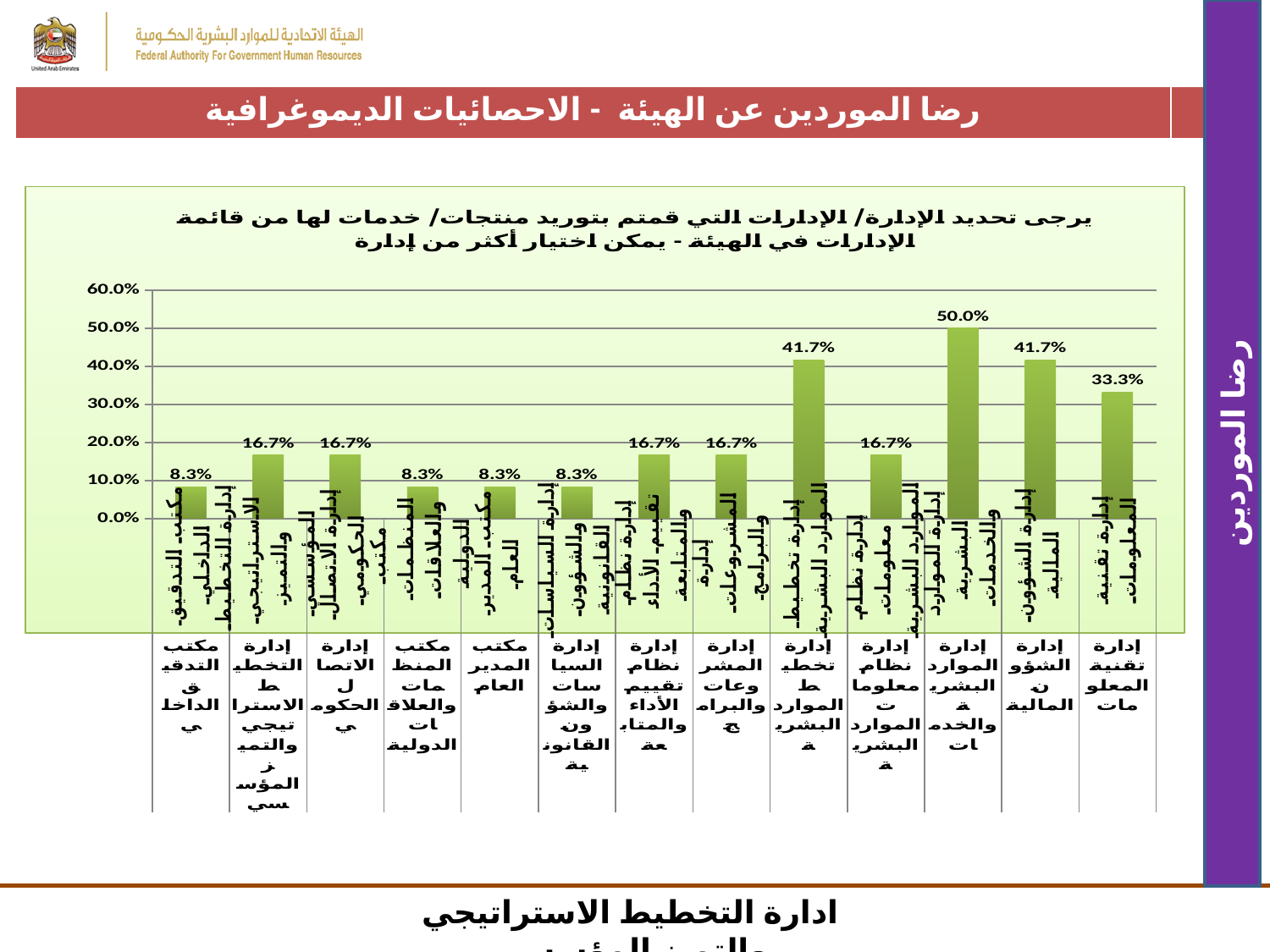
What is the highest value shown on the vertical axis of the chart? 60.0% What is the value for مكتب التدقيق الداخلي? 8.3% What is the difference between the values for إدارة الموارد البشرية والخدمات and إدارة تقنية المعلومات? 16.7% Which department has the highest value in the chart? إدارة الموارد البشرية والخدمات How many categories (departments) are plotted in the chart? 13 What is the value for إدارة الموارد البشرية والخدمات? 50.0% What type of chart is shown on the slide? bar chart What is the value for إدارة تخطيط الموارد البشرية? 41.7% Which is larger, the value for إدارة الشؤون المالية or the value for إدارة تقنية المعلومات? إدارة الشؤون المالية What is the value for إدارة تقنية المعلومات? 33.3% Is the value for إدارة الشؤون المالية greater or less than 30.0%? greater What is the value for إدارة الاتصال الحكومي? 16.7%